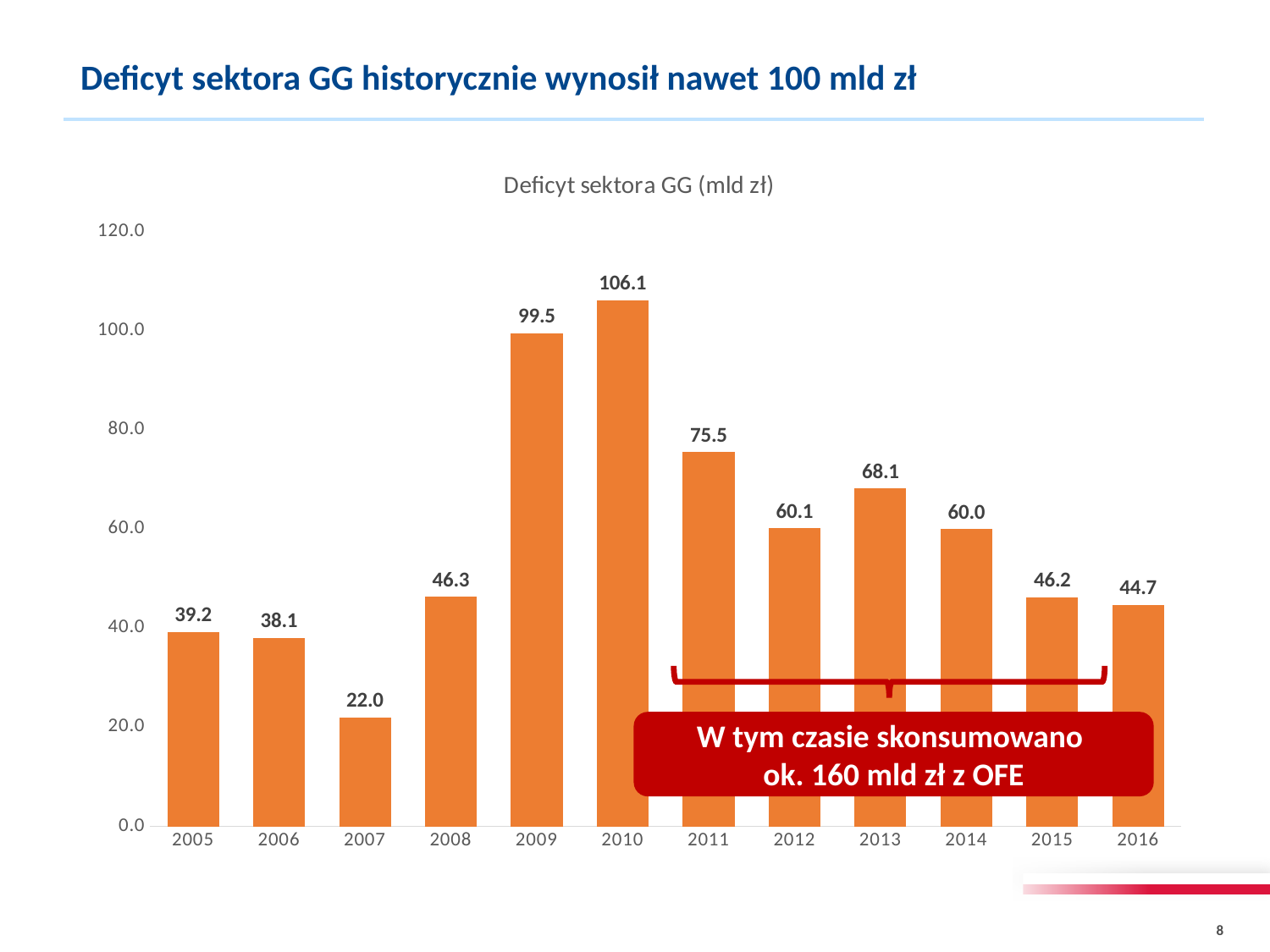
What is the value for 2013? 68.1 How many years are shown on the x axis? 12 Which year has the lowest value? 2007 What is the value for 2010? 106.1 What is the title of the chart? Deficyt sektora GG (mld zł) Which is larger, the value for 2008 or the value for 2016? 2008 What is the value for 2007? 22.0 What is the difference between the values for 2011 and 2012? 15.4 Is the value for 2009 greater or less than 80.0? greater Which year has the highest value? 2010 What is the difference between the values for 2010 and 2009? 6.6 What kind of chart is this? bar chart